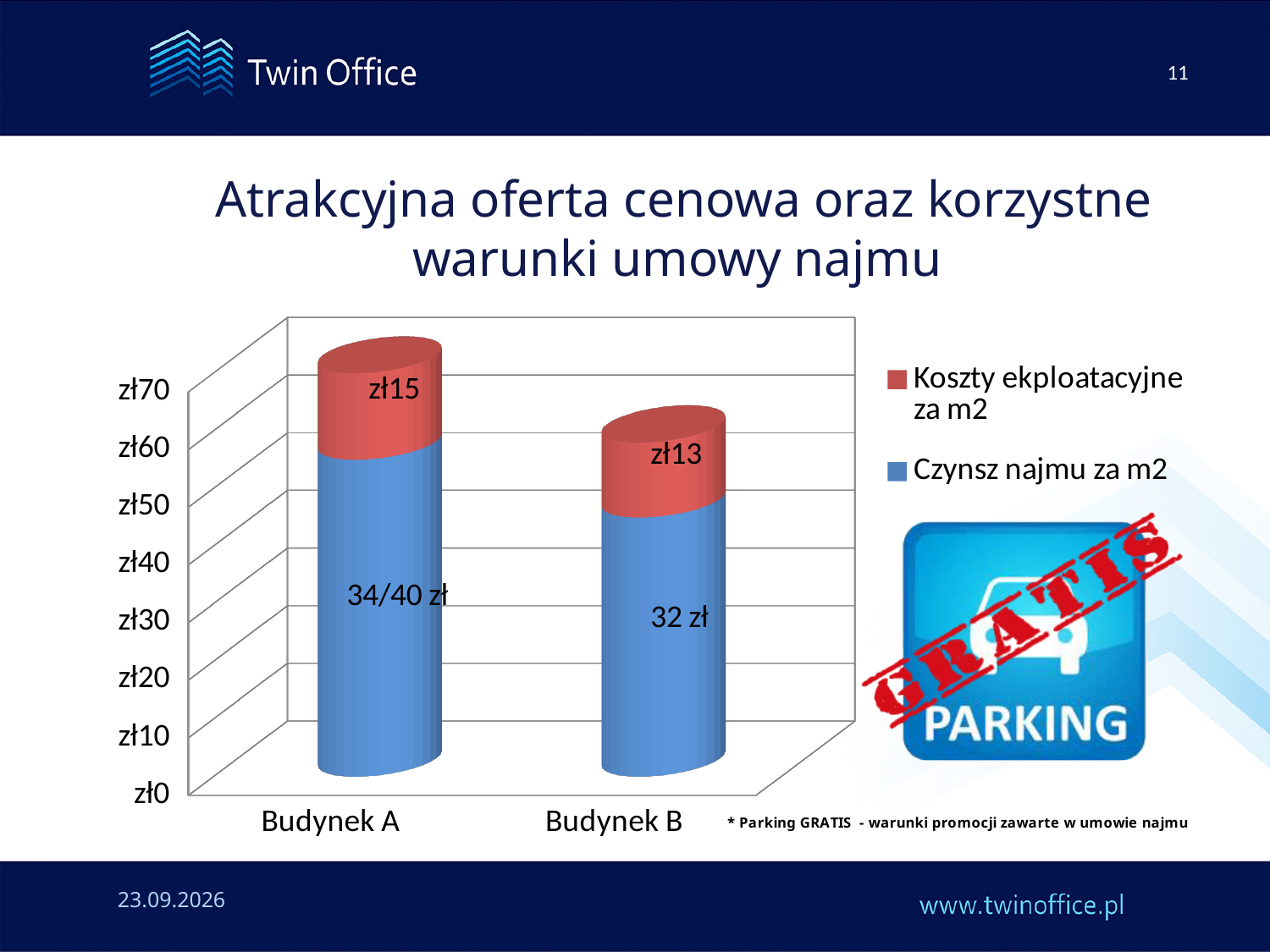
What is the value of 'Koszty ekploatacyjne za m2' for Budynek B? zł13 What kind of chart is shown on the slide? stacked bar chart How many buildings (categories) are shown on the x axis of the chart? 2 What label is printed on the 'Czynsz najmu za m2' segment for Budynek A? 34/40 zł What is the difference in 'Koszty ekploatacyjne za m2' between Budynek A and Budynek B? zł2 How many series does the chart legend list? 2 Is the total stacked value for Budynek A greater or less than zł50? greater What is the value of 'Koszty ekploatacyjne za m2' for Budynek A? zł15 What is the value of 'Czynsz najmu za m2' for Budynek B? 32 zł Which colour represents 'Czynsz najmu za m2' in the chart? blue Which building has the higher 'Koszty ekploatacyjne za m2'? Budynek A